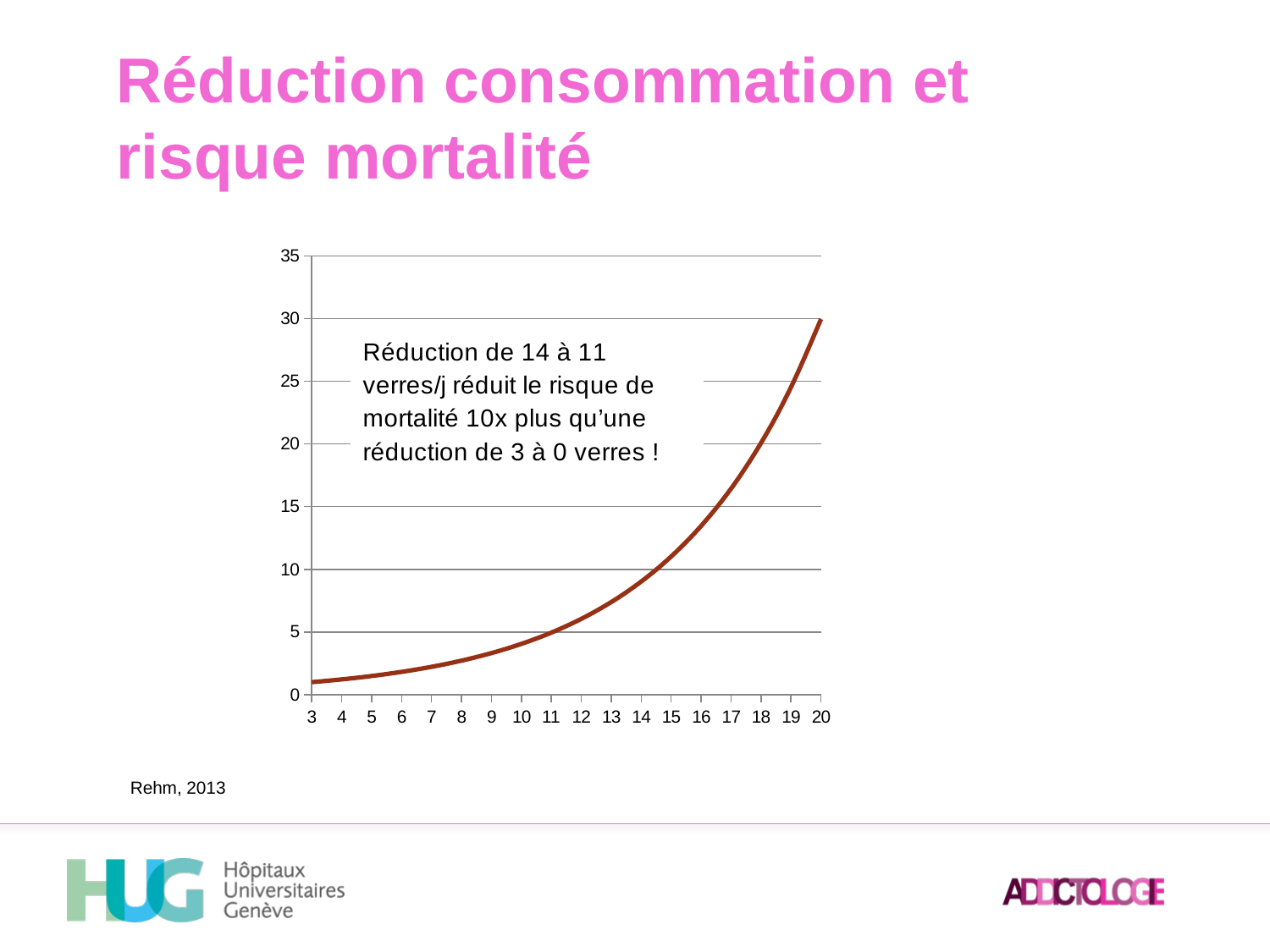
Is the value of the curve at x = 13 greater or less than 10? less Which has the larger value on the curve, x = 8 or x = 16? 16 Do the values on the chart rise or fall as the x axis goes from 3 to 20? rise What kind of chart is shown on the slide? line chart How many points are marked along the x axis of the chart? 18 Is the value of the curve at x = 20 greater or less than 25? greater At which x-axis value does the curve reach its highest point? 20 What is the title of the slide containing the chart? Réduction consommation et risque mortalité What source is cited below the chart? Rehm, 2013 At which x-axis value is the curve at its lowest point? 3 Is the value of the curve at x = 10 greater or less than 5? less